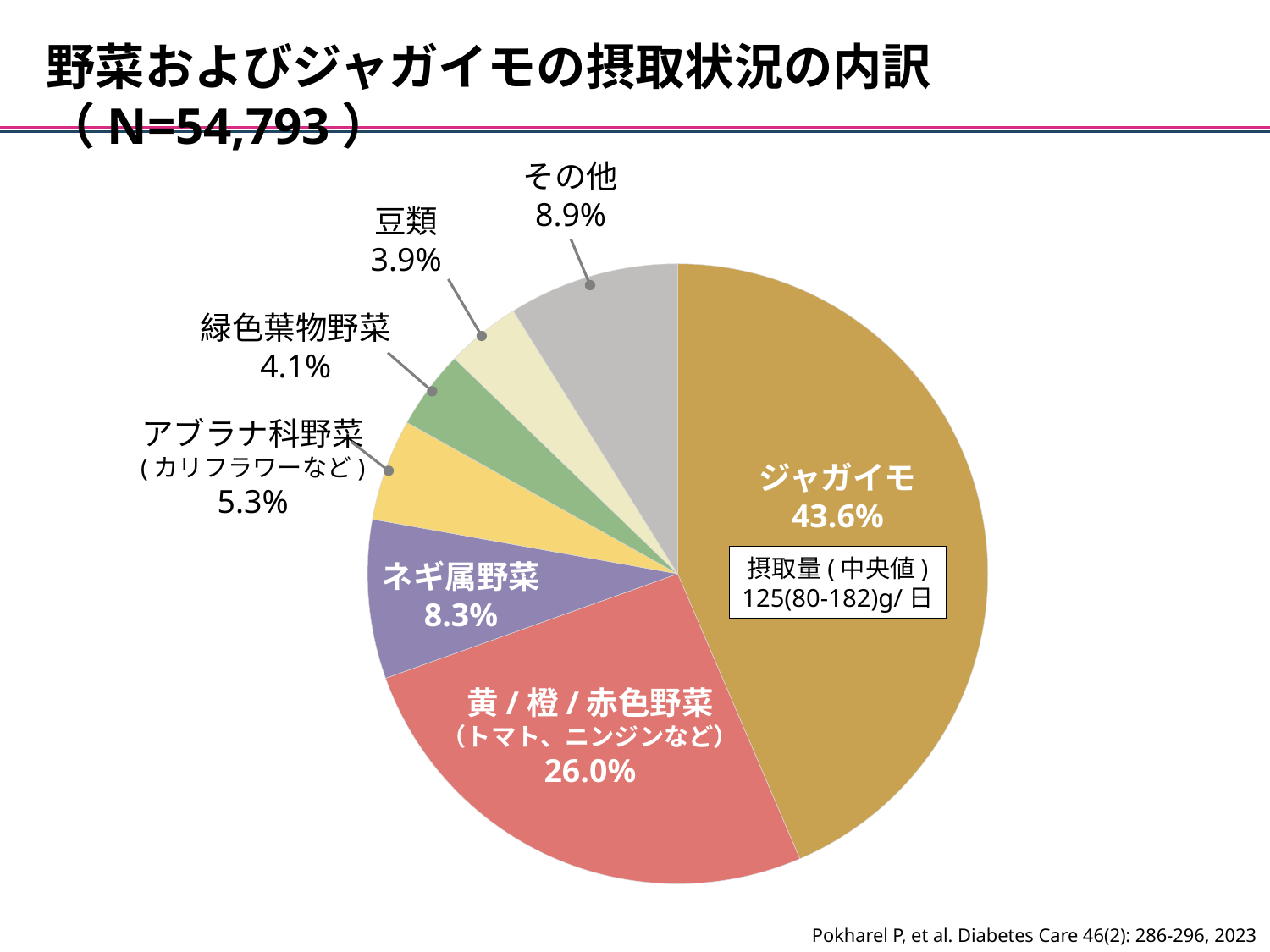
What is the value shown for 黄/橙/赤色野菜 (トマト、ニンジンなど)? 26.0% What is the value shown for その他? 8.9% What type of chart is shown on the slide? Pie chart What share of the pie does ジャガイモ account for? 43.6% What is the value shown for 豆類? 3.9% Which category has the smallest slice of the pie? 豆類 What is the value shown for 緑色葉物野菜? 4.1% What is the value shown for アブラナ科野菜 (カリフラワーなど)? 5.3% What is the value shown for ネギ属野菜? 8.3% How many categories are shown in the pie chart? 7 Which category has the largest slice of the pie? ジャガイモ What is the difference between the shares of ジャガイモ and 黄/橙/赤色野菜? 17.6%